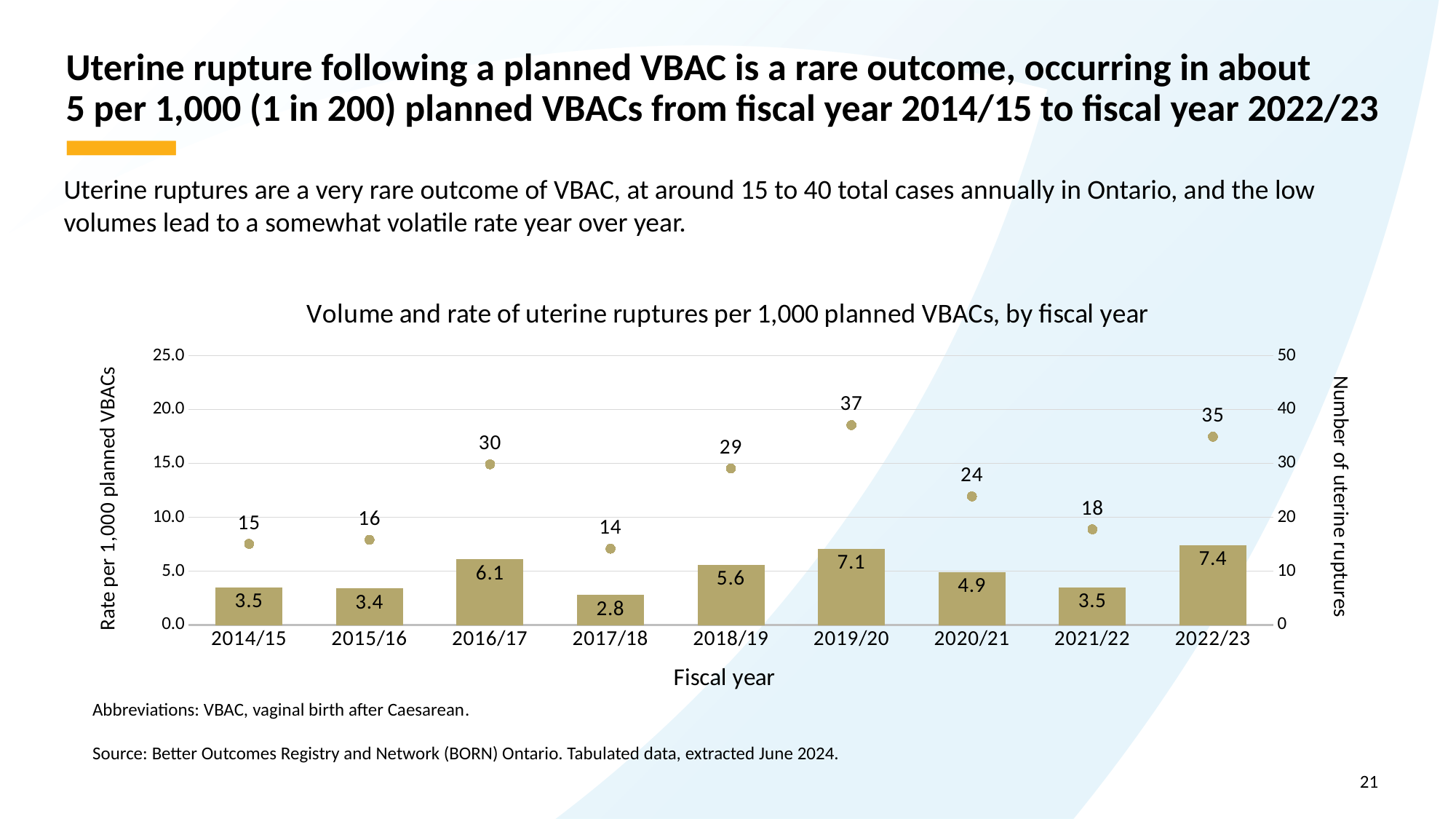
What is the difference in the rate per 1,000 planned VBACs between 2022/23 and 2014/15? 3.9 What is the number of uterine ruptures in 2019/20? 37 What is the title of the chart? Volume and rate of uterine ruptures per 1,000 planned VBACs, by fiscal year Which fiscal year has the lowest rate of uterine ruptures per 1,000 planned VBACs? 2017/18 How many fiscal years are shown on the x axis of the chart? 9 Which fiscal year has the lowest number of uterine ruptures? 2017/18 What is the label of the right-hand vertical axis? Number of uterine ruptures What kind of chart is used to show the rate per 1,000 planned VBACs? Bar chart What is the rate of uterine ruptures per 1,000 planned VBACs in 2016/17? 6.1 Which fiscal year has the highest rate of uterine ruptures per 1,000 planned VBACs? 2022/23 Which fiscal year has the larger number of uterine ruptures, 2018/19 or 2020/21? 2018/19 What is the difference in the number of uterine ruptures between 2019/20 and 2017/18? 23